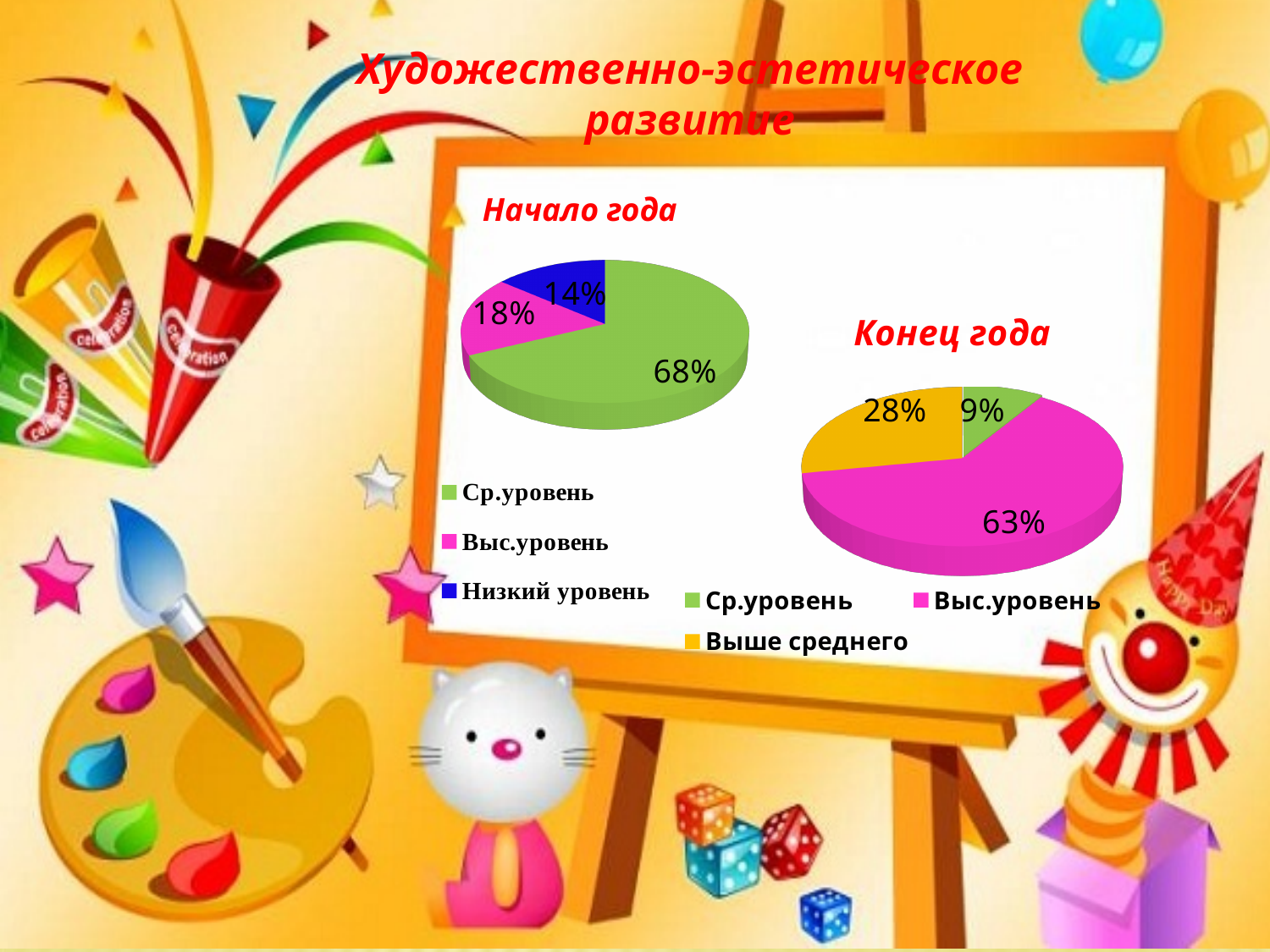
In the "Конец года" chart, what is the value for Выше среднего? 28% How many slices does the "Начало года" chart have? 3 In the "Начало года" chart, what is the value for Ср.уровень? 68% In the "Конец года" chart, what is the value for Выс.уровень? 63% In the "Начало года" chart, which category has the largest share? Ср.уровень In the "Начало года" chart, what is the difference between Выс.уровень and Низкий уровень? 4% In the "Конец года" chart, what colour is the Выше среднего slice? Yellow In the "Конец года" chart, which category has the smallest share? Ср.уровень In the "Конец года" chart, which is larger: Выше среднего or Ср.уровень? Выше среднего What type of chart is the "Конец года" chart? Pie chart In the "Начало года" chart, what is the value for Низкий уровень? 14% In the "Конец года" chart, what is the difference between Выс.уровень and Выше среднего? 35%